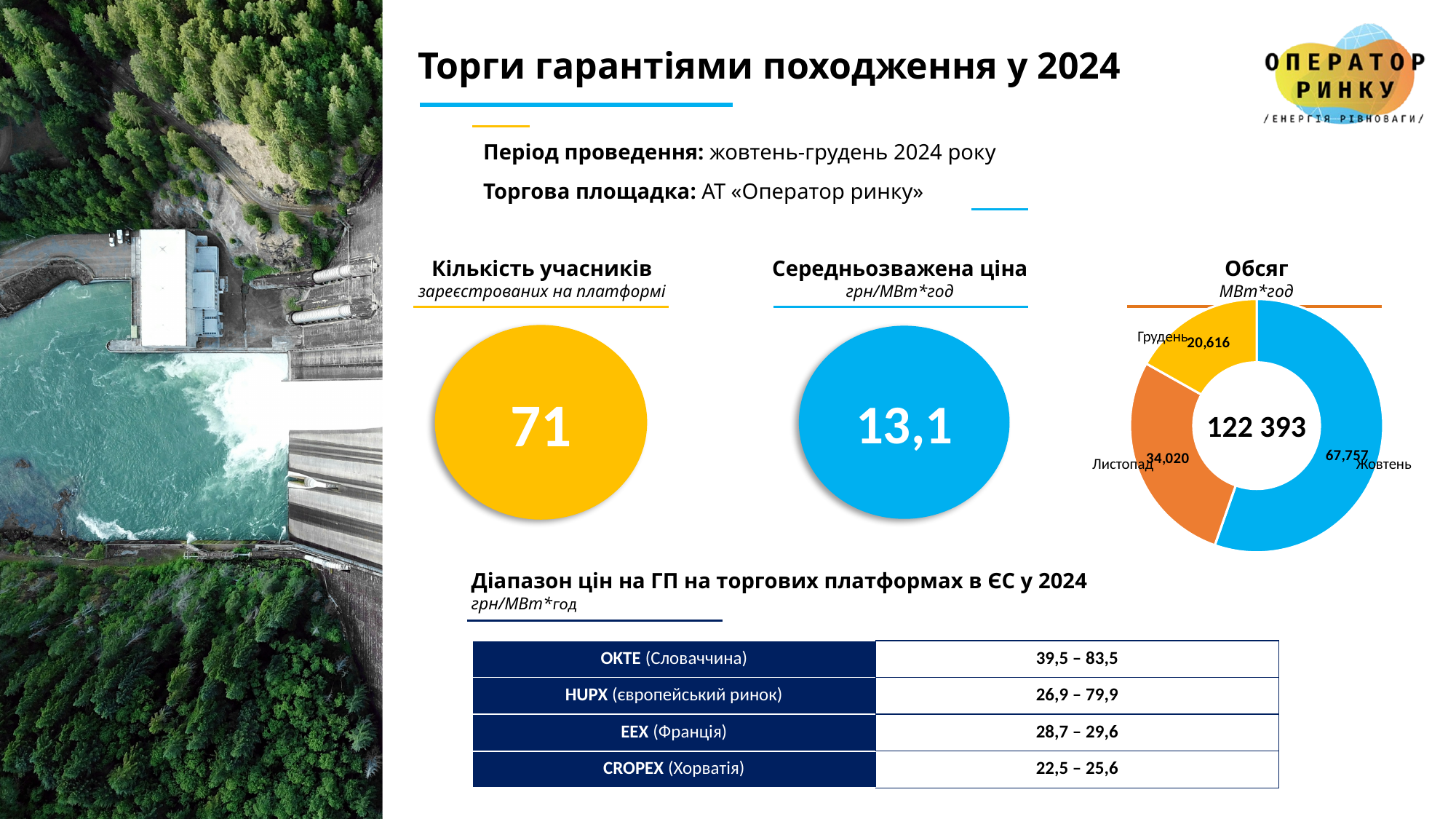
In the "Обсяг" donut chart, which month has the largest volume? Жовтень What unit is given under the title of the "Обсяг" donut chart? МВт*год What total value is shown in the centre of the "Обсяг" donut chart? 122 393 In the "Обсяг" donut chart, what is the difference between the values for Жовтень and Листопад? 33,737 What kind of chart is used to show "Обсяг"? Donut (pie) chart In the "Обсяг" donut chart, what is the value for Жовтень? 67,757 In the "Обсяг" donut chart, which is larger: the value for Листопад or the value for Грудень? Листопад How many months (slices) are shown in the "Обсяг" donut chart? 3 In the "Обсяг" donut chart, what is the difference between the values for Листопад and Грудень? 13,404 In the "Обсяг" donut chart, what is the value for Грудень? 20,616 In the "Обсяг" donut chart, which month has the smallest volume? Грудень In the "Обсяг" donut chart, what is the value for Листопад? 34,020